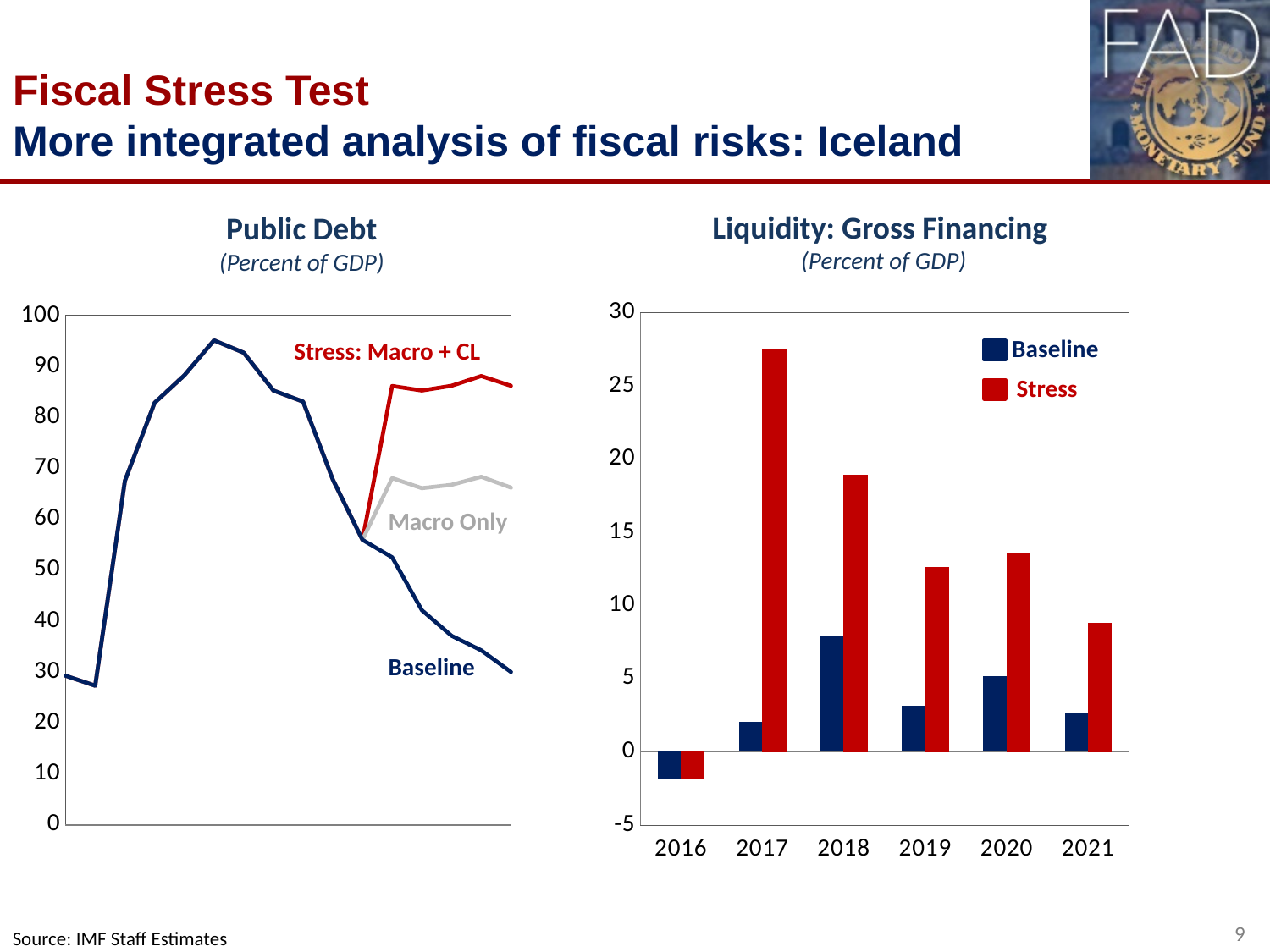
In the Liquidity: Gross Financing chart, is the Stress value for 2021 greater or less than 10? less In the Liquidity: Gross Financing chart, is the Stress value for 2017 greater or less than 25? greater What kind of chart is the Public Debt chart? line chart How many years are shown on the x axis of the Liquidity: Gross Financing chart? 6 What kind of chart is the Liquidity: Gross Financing chart? bar chart In the Liquidity: Gross Financing chart, is the Baseline value for 2016 greater or less than 0? less In the Liquidity: Gross Financing chart, which year has the highest Stress value? 2017 What are the three lines labelled in the Public Debt chart? Stress: Macro + CL, Macro Only, Baseline In the Liquidity: Gross Financing chart, which is larger for 2018, Baseline or Stress? Stress How many series does the legend of the Liquidity: Gross Financing chart list? 2 In the Liquidity: Gross Financing chart, which year has the lowest Stress value? 2016